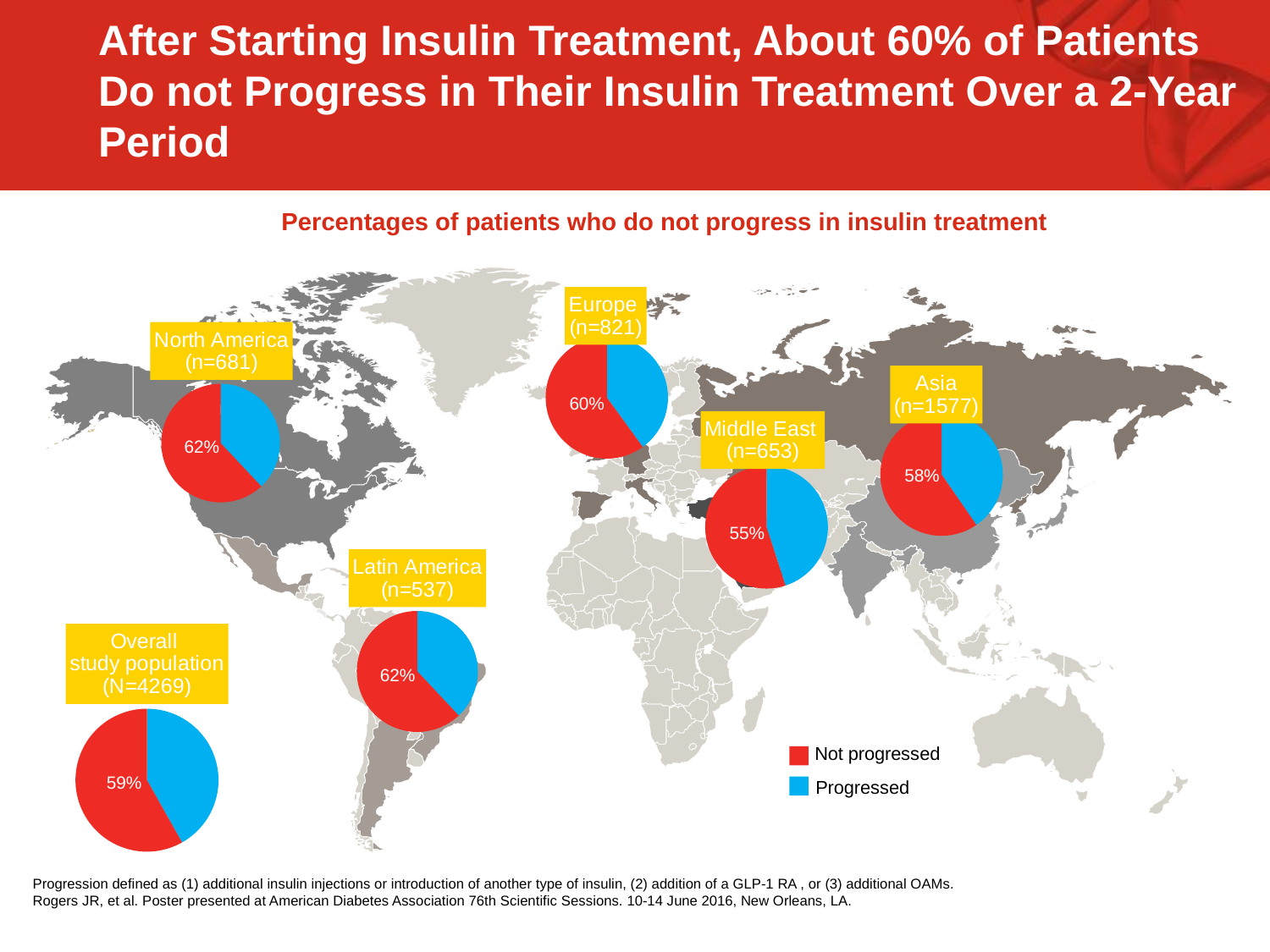
What type of chart is used to show the percentages for each region? Pie chart In the Overall study population pie chart, what percentage of patients did not progress? 59% How many pie charts are shown on the slide? 6 Across the regional pie charts, which region has the lowest percentage of patients who did not progress? Middle East In the Europe pie chart, what percentage of patients did not progress? 60% In the Asia pie chart, what percentage of patients did not progress? 58% In the Middle East pie chart, what percentage of patients did not progress? 55% Which is larger: the not-progressed percentage in the Europe pie chart or in the Middle East pie chart? Europe What is the difference in percentage points between the not-progressed share in the North America pie chart and the Asia pie chart? 4 percentage points In the North America pie chart, what percentage of patients did not progress in insulin treatment? 62% According to the legend, which colour represents patients who did not progress? Red How many categories does the legend list for the pie charts? 2